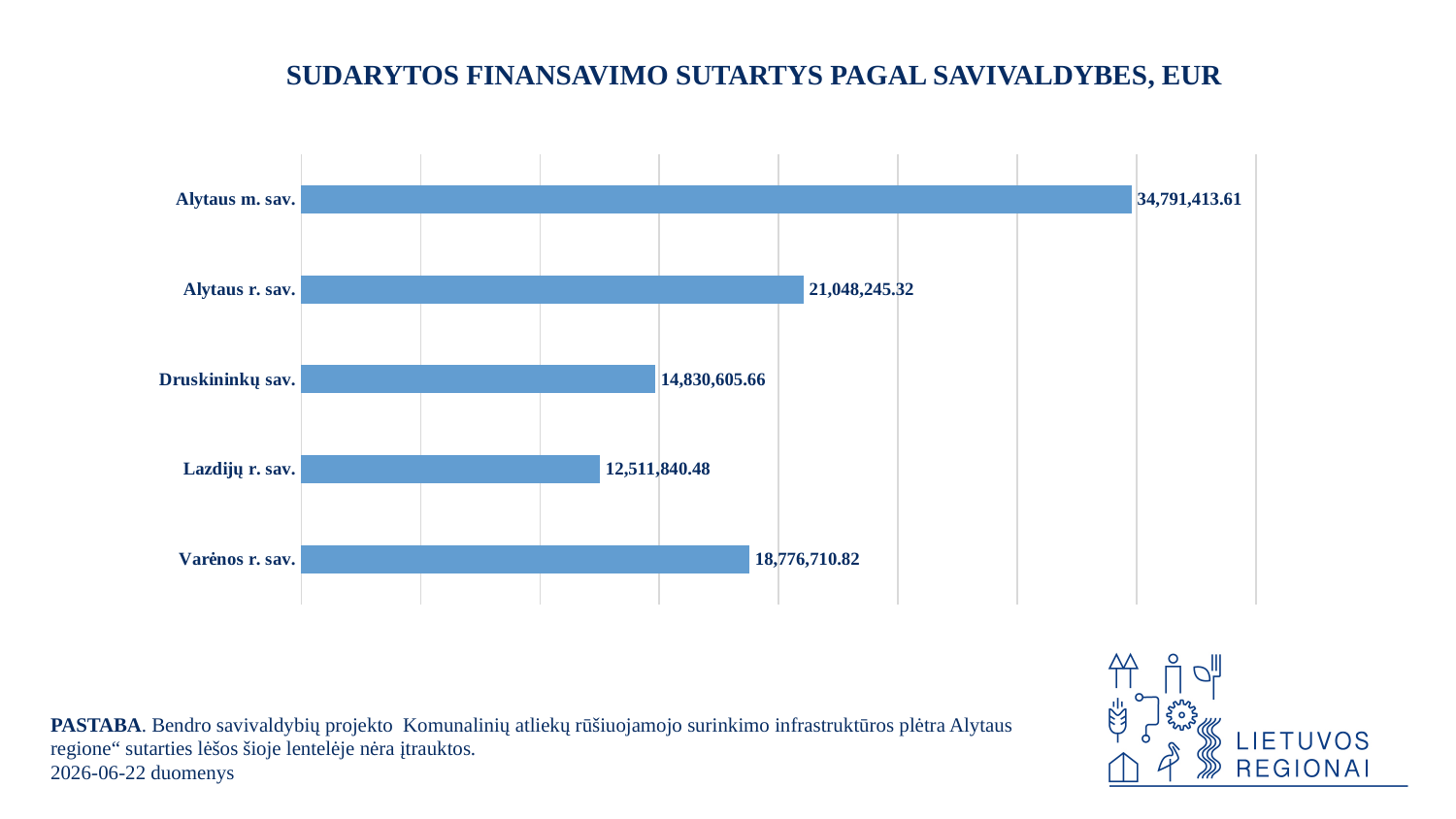
Which municipality has the lowest value? Lazdijų r. sav. What is the value for Alytaus m. sav.? 34,791,413.61 What is the title of the chart? SUDARYTOS FINANSAVIMO SUTARTYS PAGAL SAVIVALDYBES, EUR Which is larger, the value for Varėnos r. sav. or the value for Druskininkų sav.? Varėnos r. sav. What is the value for Druskininkų sav.? 14,830,605.66 What is the difference between the values for Varėnos r. sav. and Lazdijų r. sav.? 6,264,870.34 What is the value for Lazdijų r. sav.? 12,511,840.48 What is the value for Varėnos r. sav.? 18,776,710.82 How many municipalities are shown in the chart? 5 Which municipality has the highest value? Alytaus m. sav. What is the difference between the values for Alytaus m. sav. and Alytaus r. sav.? 13,743,168.29 What kind of chart is shown on the slide? Bar chart